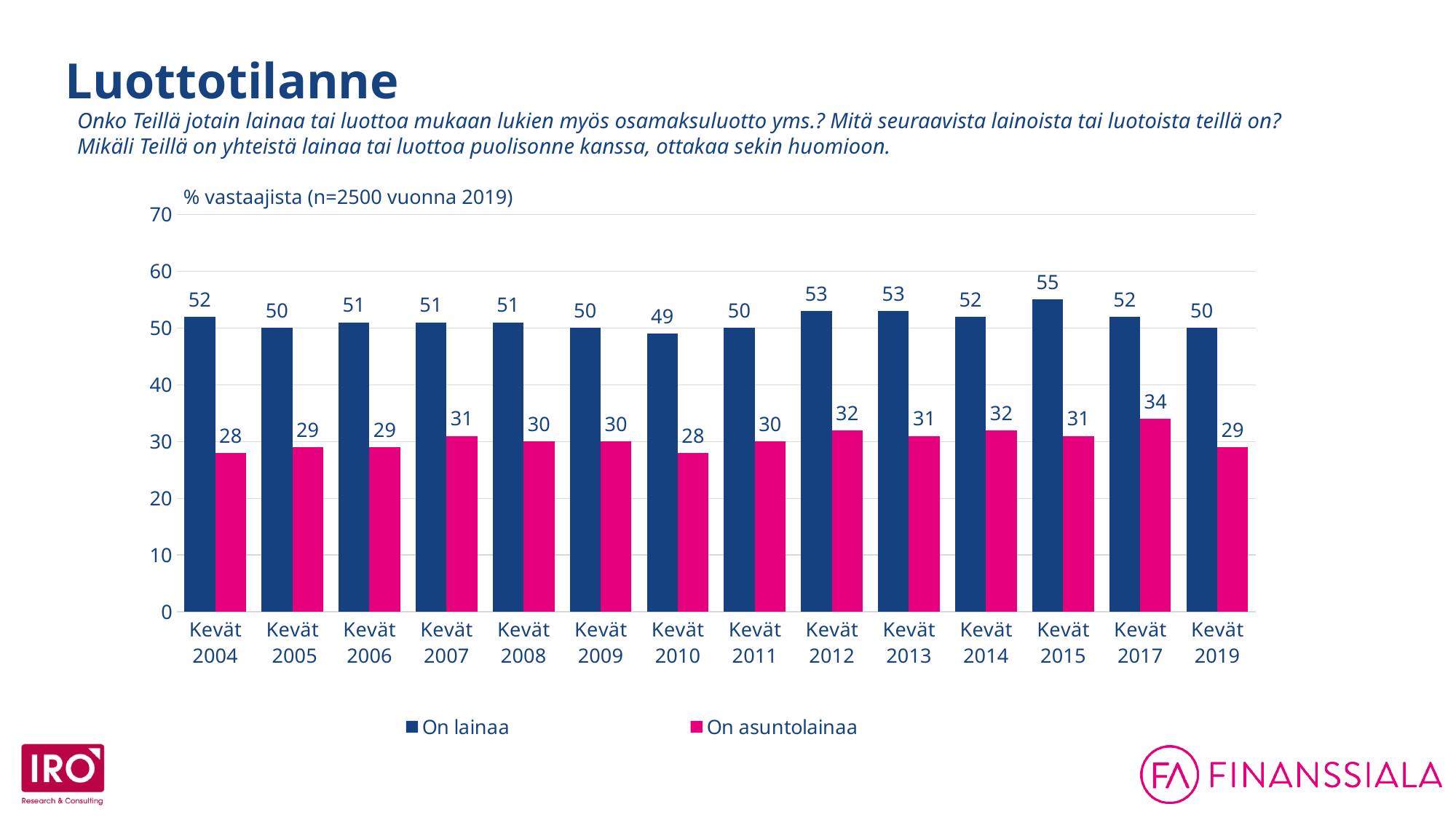
What is the value for "On asuntolainaa" in Kevät 2017? 34 What is the value for "On lainaa" in Kevät 2010? 49 In which period is "On asuntolainaa" highest? Kevät 2017 What kind of chart is shown on the slide? Bar chart How many periods are shown on the x axis? 14 In which period is "On lainaa" lowest? Kevät 2010 Which is larger: "On asuntolainaa" in Kevät 2017 or in Kevät 2019? Kevät 2017 What is the value for "On lainaa" in Kevät 2015? 55 In which period is "On lainaa" highest? Kevät 2015 What is the difference between "On lainaa" and "On asuntolainaa" in Kevät 2019? 21 How many series does the legend list? 2 What is the title of the slide? Luottotilanne